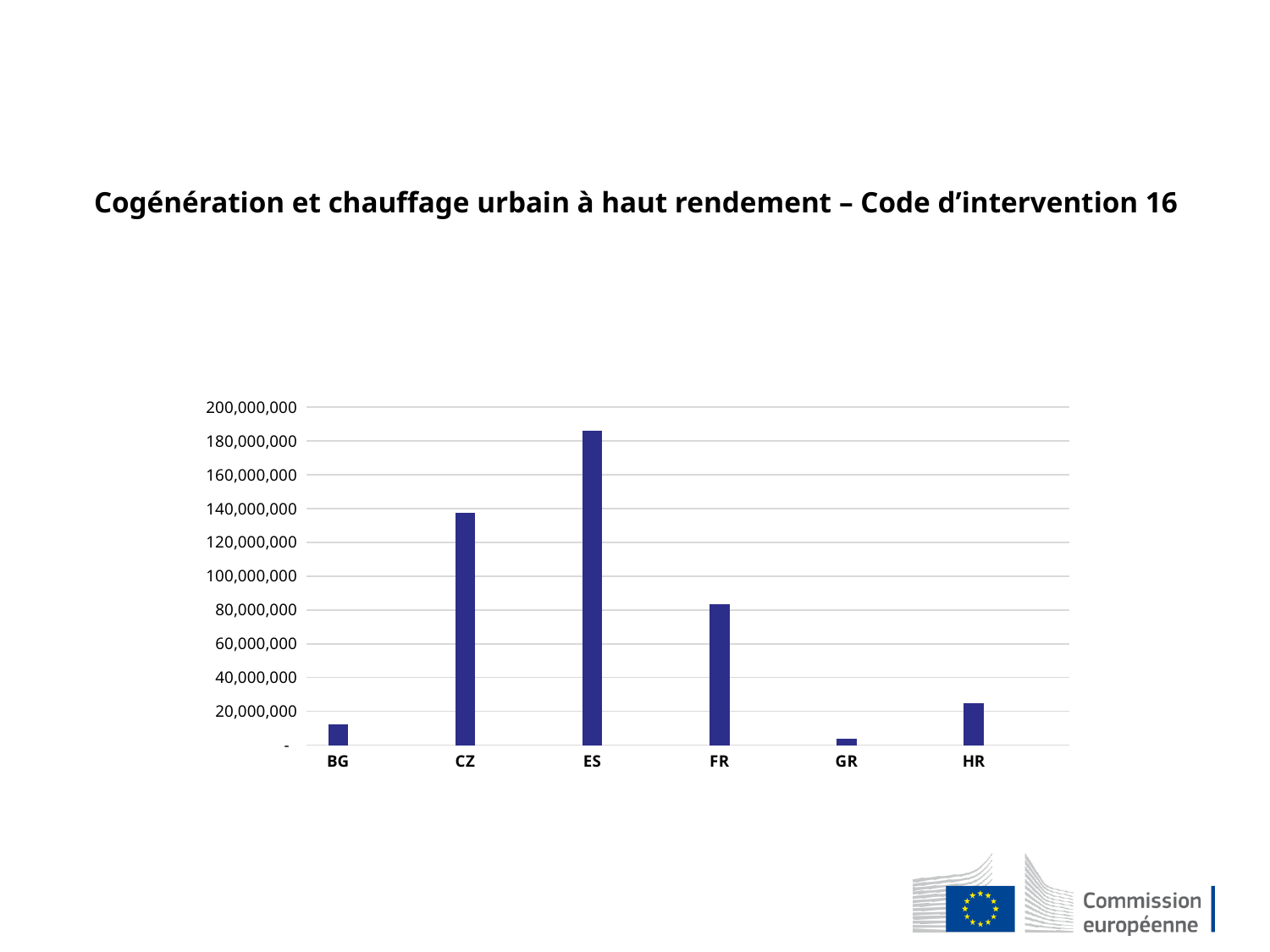
Is the value for FR greater or less than 100,000,000? less How many countries are shown on the x axis of the chart? 6 What kind of chart is shown on the slide? bar chart Which country has the highest value in the chart? ES Is the value for CZ greater or less than 120,000,000? greater What is the title of the chart on the slide? Cogénération et chauffage urbain à haut rendement – Code d’intervention 16 Which has the larger value, CZ or FR? CZ Is the value for BG greater or less than 20,000,000? less Which country has the lowest value in the chart? GR Which has the larger value, BG or HR? HR